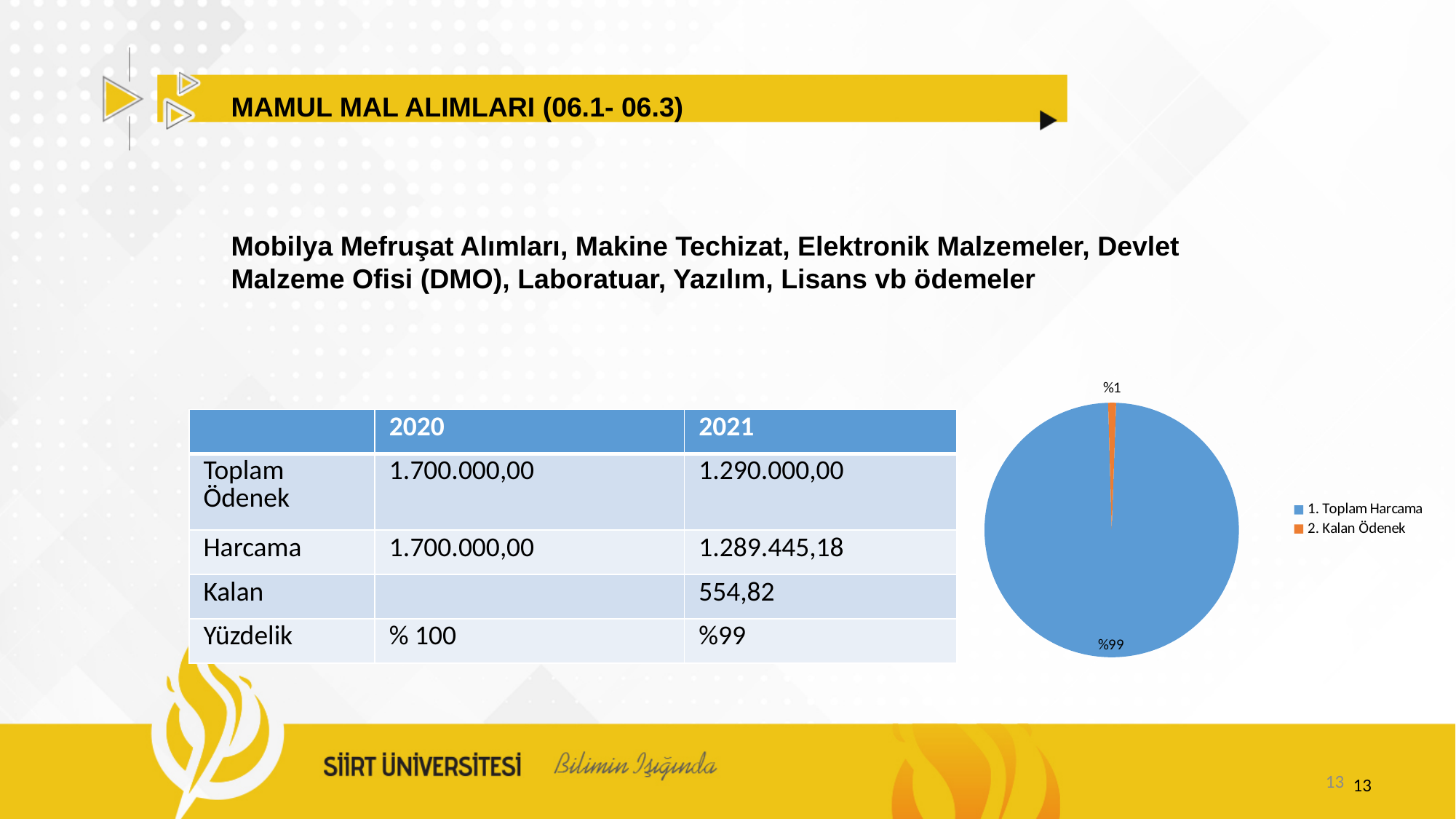
In the pie chart, which is larger: "1. Toplam Harcama" or "2. Kalan Ödenek"? 1. Toplam Harcama Which slice of the pie chart is the largest? 1. Toplam Harcama Which slice of the pie chart is the smallest? 2. Kalan Ödenek What share of the pie chart does "1. Toplam Harcama" take? %99 What colour is the "2. Kalan Ödenek" slice in the pie chart? orange What is the difference in percentage points between the "1. Toplam Harcama" slice and the "2. Kalan Ödenek" slice in the pie chart? 98 What share of the pie chart does "2. Kalan Ödenek" take? %1 How many entries does the pie chart's legend list? 2 What kind of chart is shown on the right side of the slide? pie chart How many slices does the pie chart have? 2 What is the label of the blue slice in the pie chart's legend? 1. Toplam Harcama